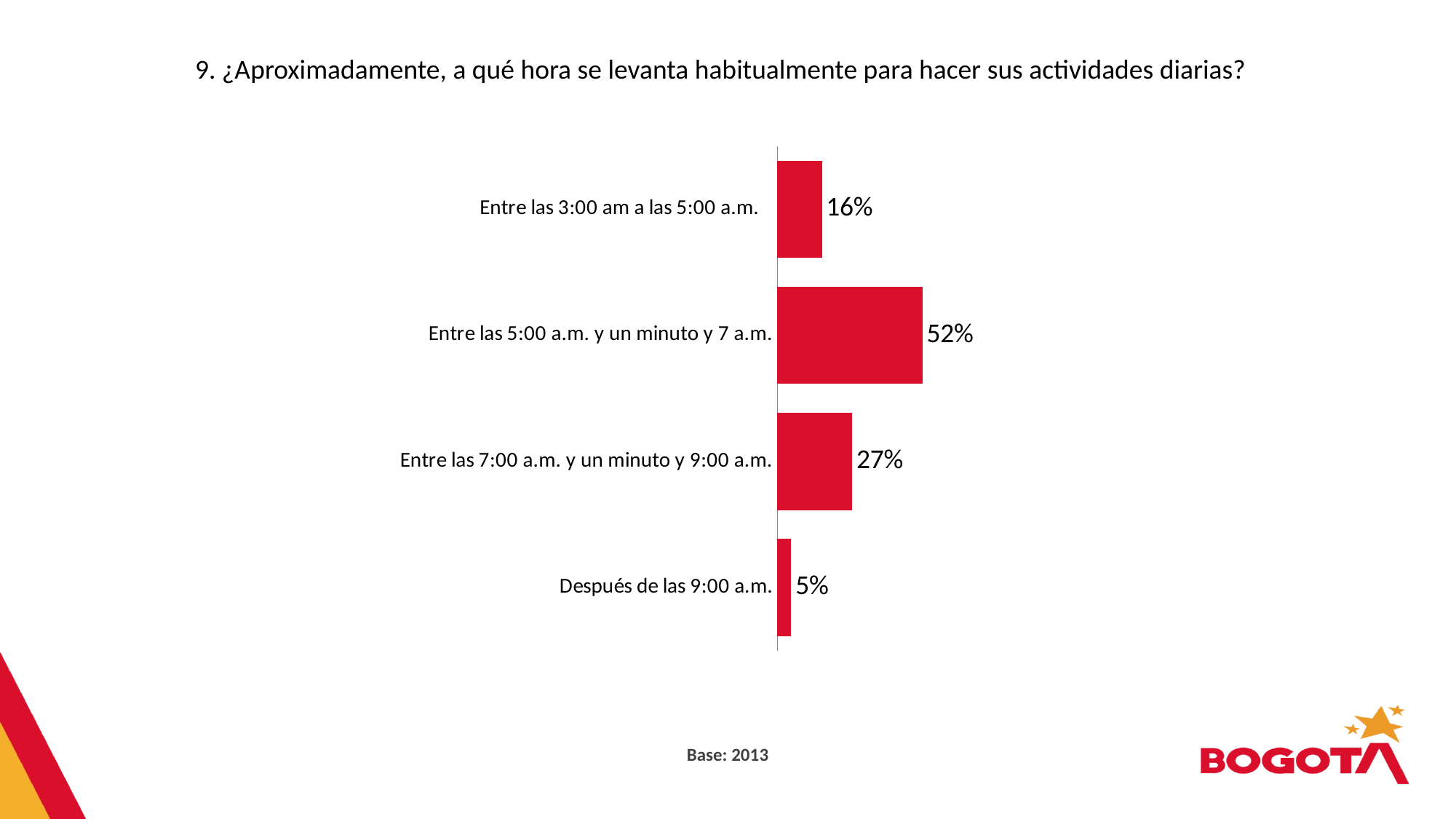
Which time range has the lowest percentage? Después de las 9:00 a.m. Which is larger: the value for 'Entre las 3:00 am a las 5:00 a.m.' or the value for 'Después de las 9:00 a.m.'? Entre las 3:00 am a las 5:00 a.m. What base (sample size) is stated below the chart? 2013 What kind of chart is shown on the slide? Bar chart What is the difference between the value for 'Entre las 3:00 am a las 5:00 a.m.' and the value for 'Después de las 9:00 a.m.'? 11% What is the value for 'Entre las 7:00 a.m. y un minuto y 9:00 a.m.'? 27% What is the difference between the value for 'Entre las 5:00 a.m. y un minuto y 7 a.m.' and the value for 'Entre las 7:00 a.m. y un minuto y 9:00 a.m.'? 25% Which time range has the highest percentage? Entre las 5:00 a.m. y un minuto y 7 a.m. What percentage of respondents get up between 3:00 am and 5:00 a.m.? 16% What is the value for 'Entre las 5:00 a.m. y un minuto y 7 a.m.'? 52% What percentage of respondents get up after 9:00 a.m.? 5% How many time-range categories are shown in the chart? 4